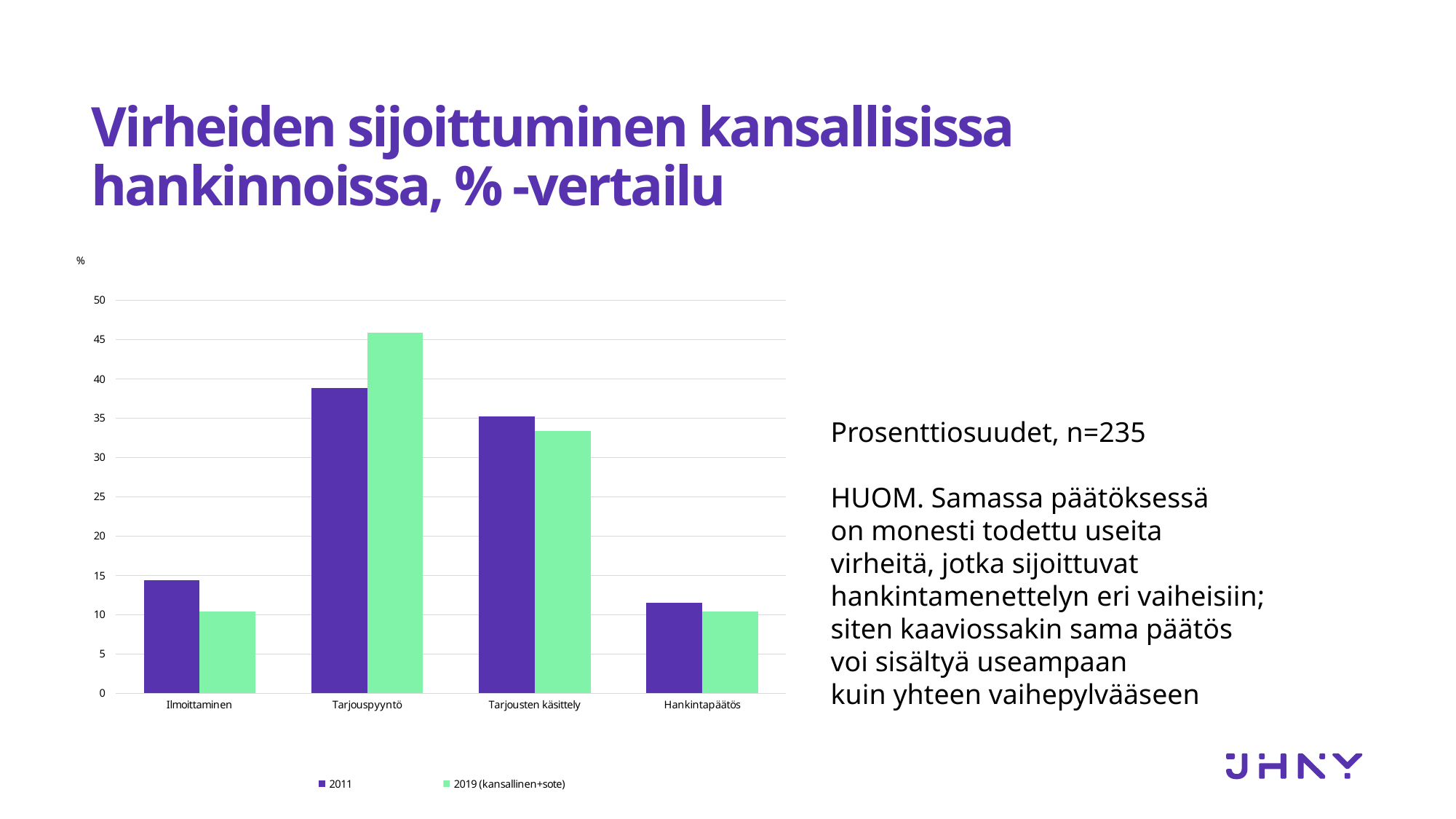
For Tarjousten käsittely, which series has the larger value, 2011 or 2019 (kansallinen+sote)? 2011 What kind of chart is shown on the slide? bar chart Is the 2011 value for Ilmoittaminen greater or less than 10? greater How many categories are shown on the x axis of the chart? 4 What are the two series named in the chart's legend? 2011 and 2019 (kansallinen+sote) Is the 2011 value for Tarjouspyyntö greater or less than 40? less How many series does the chart's legend list? 2 Which category has the highest value for the 2011 series? Tarjouspyyntö Which category has the lowest value for the 2011 series? Hankintapäätös For Tarjouspyyntö, which series has the larger value, 2011 or 2019 (kansallinen+sote)? 2019 (kansallinen+sote) Which category has the highest value for the 2019 (kansallinen+sote) series? Tarjouspyyntö Is the 2019 (kansallinen+sote) value for Tarjouspyyntö greater or less than 40? greater